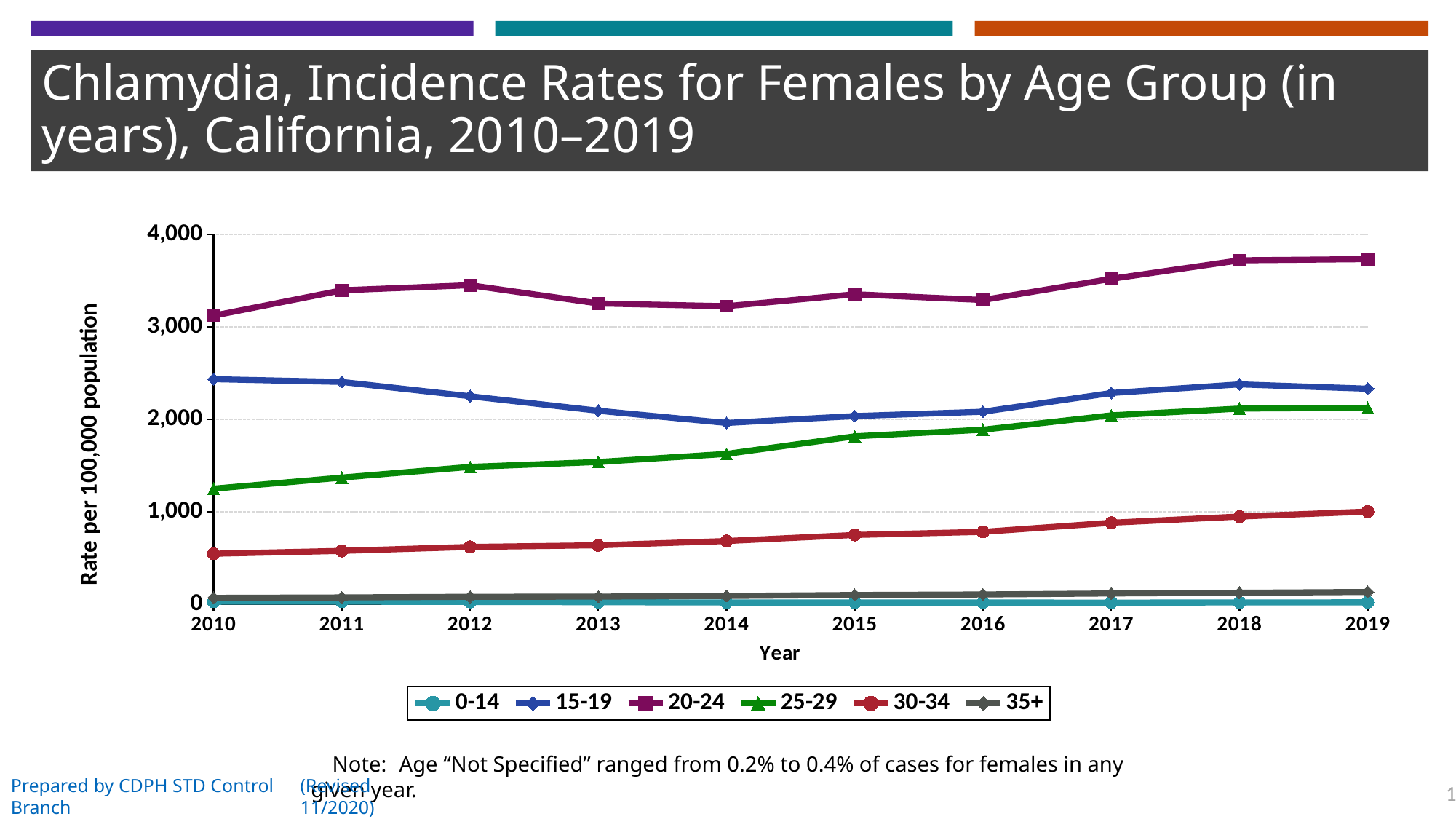
What is the label of the y axis? Rate per 100,000 population Which age group has the highest incidence rate in 2019? 20-24 Is the value for the 20-24 age group in 2010 greater or less than 3,000? greater For the 20-24 age group, is the rate higher in 2019 or in 2010? 2019 Is the value for the 30-34 age group in 2010 greater or less than 1,000? less How many years are plotted along the x axis? 10 What kind of chart is shown on the slide? line chart In 2010, which age group has the higher rate: 15-19 or 25-29? 15-19 How many age groups does the legend list? 6 Is the value for the 15-19 age group in 2010 greater or less than 2,000? greater Does the incidence rate for the 25-29 age group rise or fall from 2010 to 2019? rise Which age group has the lowest incidence rate in 2019? 0-14